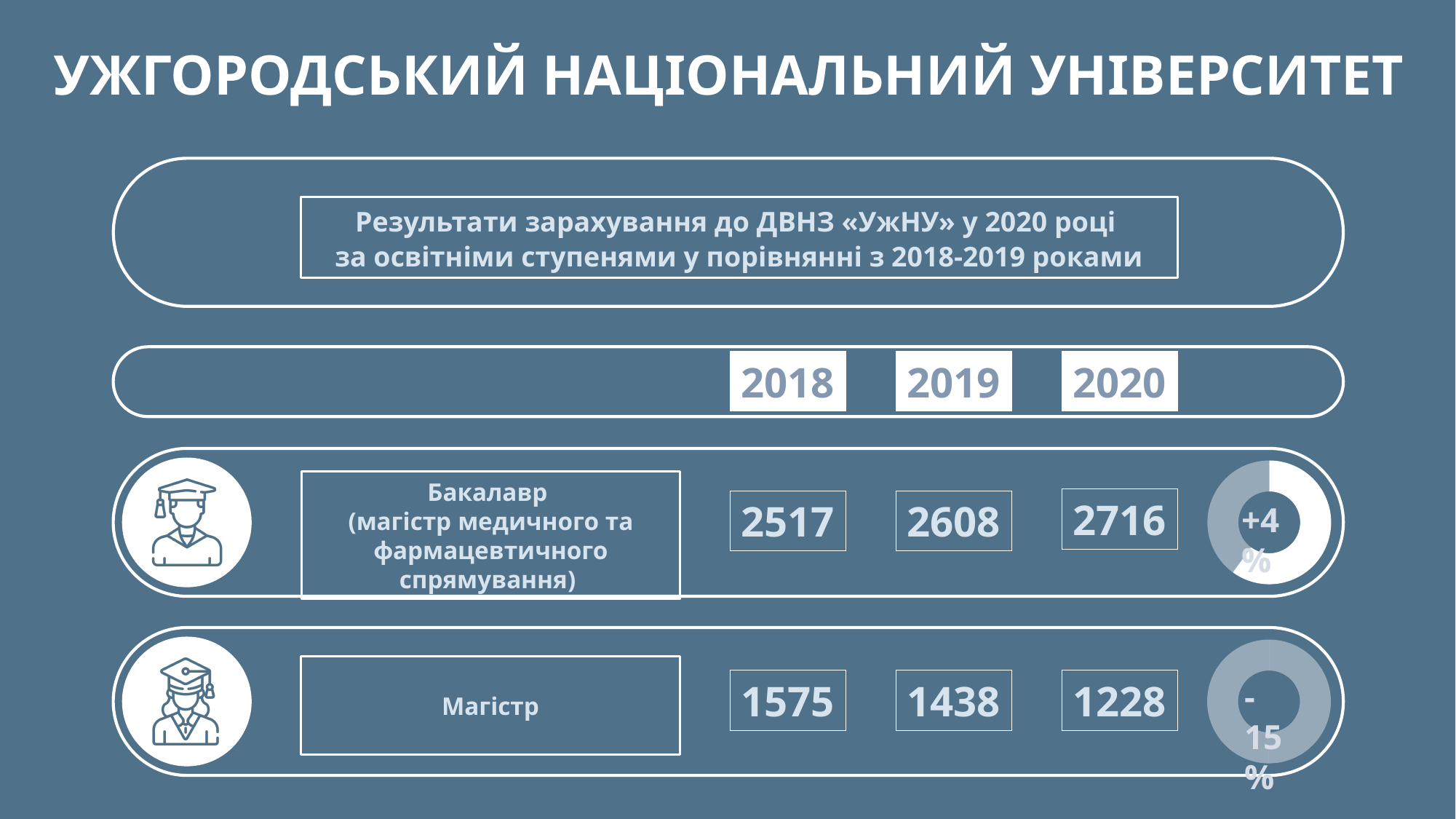
Do the Магістр values rise or fall from 2018 to 2020? Fall What is the difference between the Бакалавр values for 2020 and 2019? 108 Which row's donut chart shows a negative change? Магістр Which year has the highest Магістр value? 2018 Do the Бакалавр values rise or fall from 2018 to 2020? Rise What kind of chart is shown at the right end of the Бакалавр row? Donut (pie) chart What percentage change is shown in the donut chart for the Бакалавр row? +4% What is the 2020 value for Бакалавр? 2716 Which row's donut chart shows a positive change, Бакалавр or Магістр? Бакалавр What percentage change is shown in the donut chart for the Магістр row? -15% What is the 2020 value for Магістр? 1228 How many donut charts are on the slide? 2